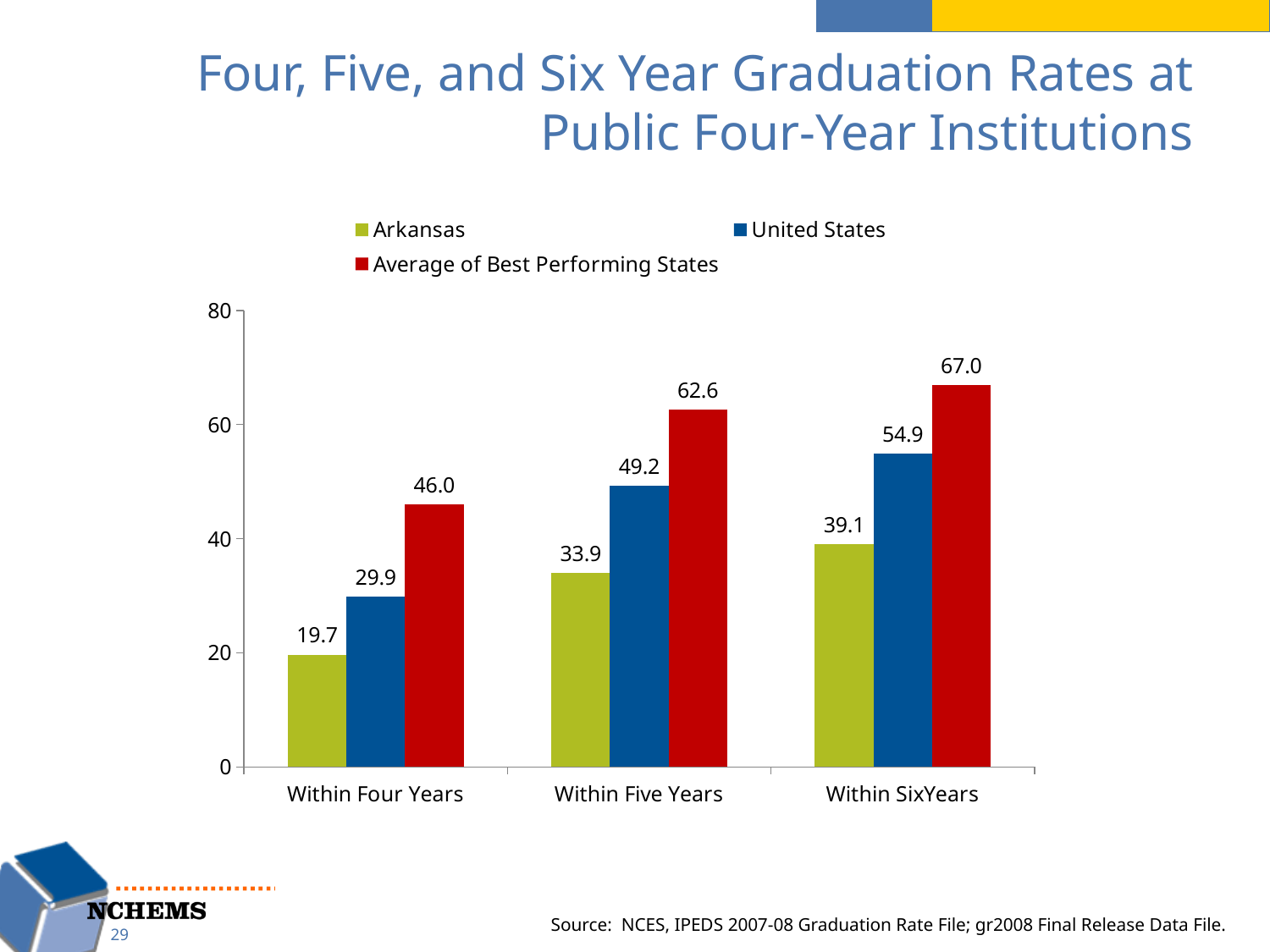
Which category has the lowest Arkansas value? Within Four Years How many series does the legend list? 3 What is the Average of Best Performing States value within six years? 67.0 Which series has the highest value within four years? Average of Best Performing States Which is larger: the United States value within six years or the Average of Best Performing States value within five years? Average of Best Performing States value within five years Is the Arkansas value within six years greater or less than 40? less What kind of chart is shown on the slide? bar chart What is the United States graduation rate within five years? 49.2 What is the Arkansas graduation rate within four years? 19.7 Do the United States values rise or fall from Within Four Years to Within Six Years? rise How many categories are shown on the x axis? 3 What is the difference between the Average of Best Performing States and Arkansas values within five years? 28.7